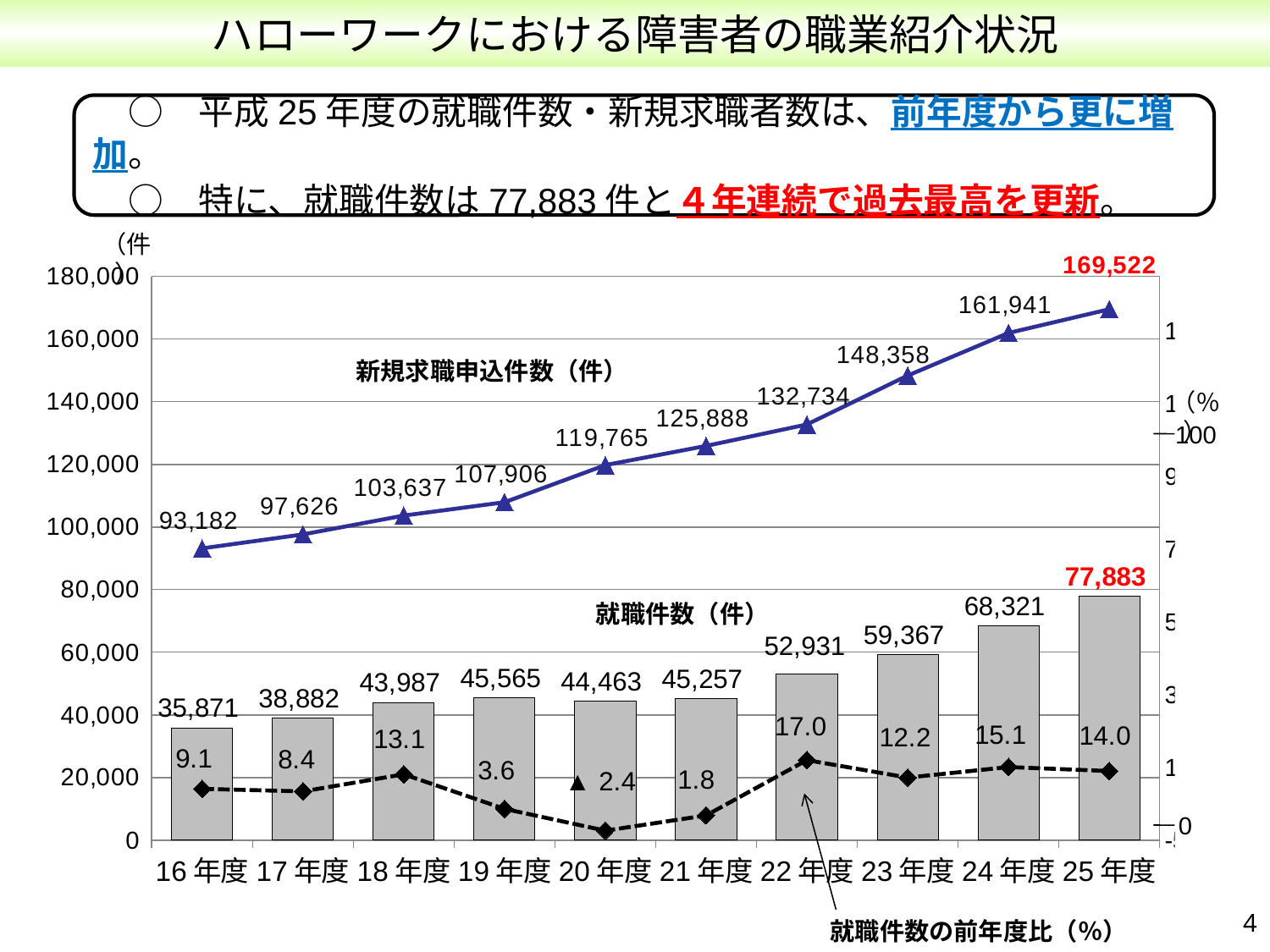
Which year has the highest 就職件数? 25年度 What is the 就職件数の前年度比 (%) for 18年度? 13.1 What is the value of 就職件数 for 22年度? 52,931 How many fiscal years are shown on the x axis? 10 What is the difference in 就職件数 between 25年度 and 24年度? 9,562 Which is larger, the 就職件数 for 19年度 or for 20年度? 19年度 Which year has the highest 就職件数の前年度比 (%)? 22年度 What is the 就職件数の前年度比 (%) for 20年度? ▲ 2.4 Does the 新規求職申込件数 line rise or fall from 16年度 to 25年度? rise Which year has the lowest 新規求職申込件数? 16年度 What is the difference in 新規求職申込件数 between 24年度 and 23年度? 13,583 What is the value of 新規求職申込件数 for 25年度? 169,522